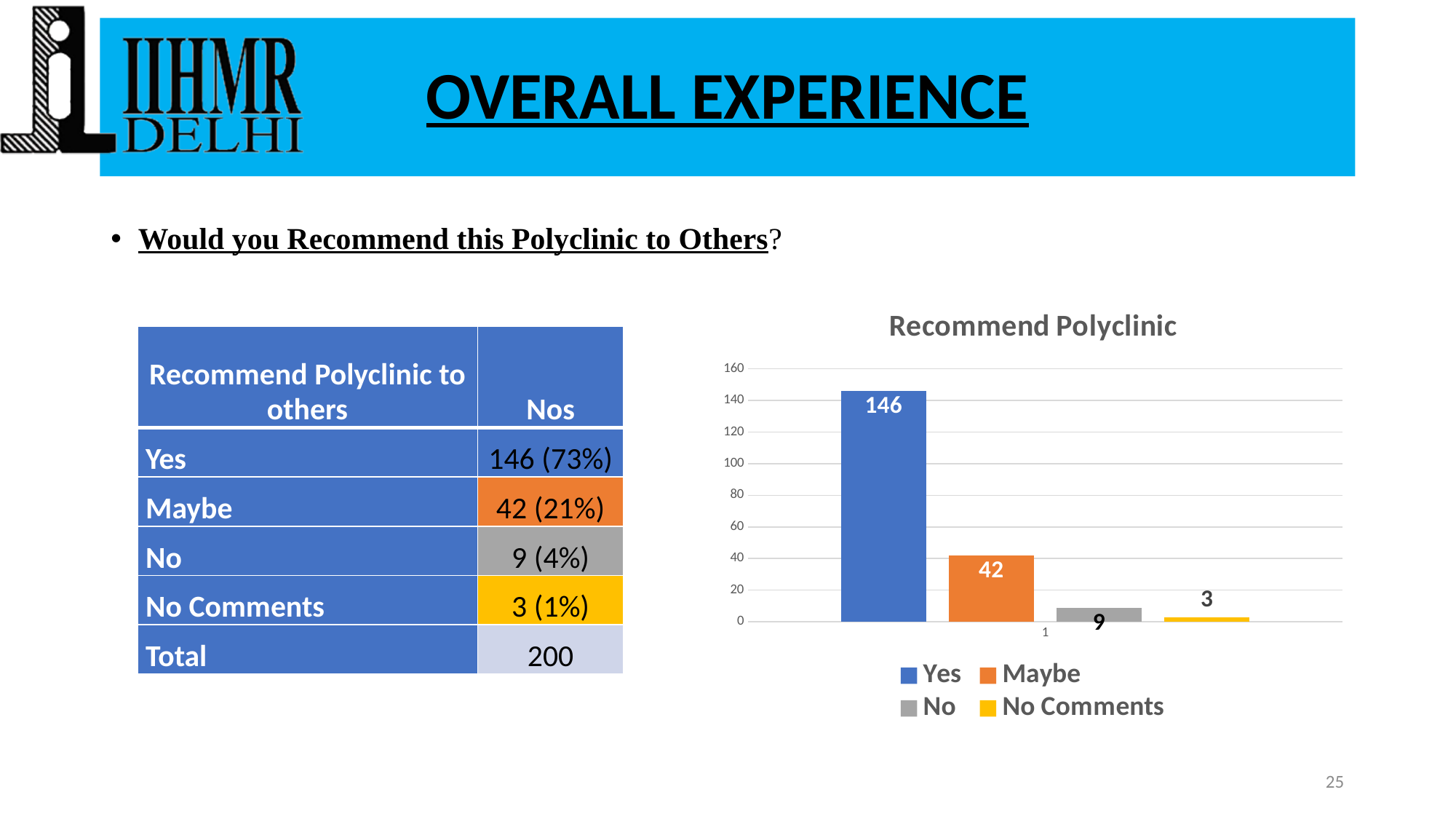
Which series has the lowest value in the Recommend Polyclinic chart? No Comments Which is larger in the Recommend Polyclinic chart, No or No Comments? No How many series does the legend of the Recommend Polyclinic chart list? 4 What kind of chart is the Recommend Polyclinic chart? Bar chart What is the value for Maybe in the Recommend Polyclinic chart? 42 What is the difference between the Yes and Maybe values in the Recommend Polyclinic chart? 104 What is the value for Yes in the Recommend Polyclinic chart? 146 What colour is the Maybe bar in the Recommend Polyclinic chart? Orange Which series has the highest value in the Recommend Polyclinic chart? Yes What is the value for No in the Recommend Polyclinic chart? 9 What is the value for No Comments in the Recommend Polyclinic chart? 3 What is the title of the chart on the slide? Recommend Polyclinic